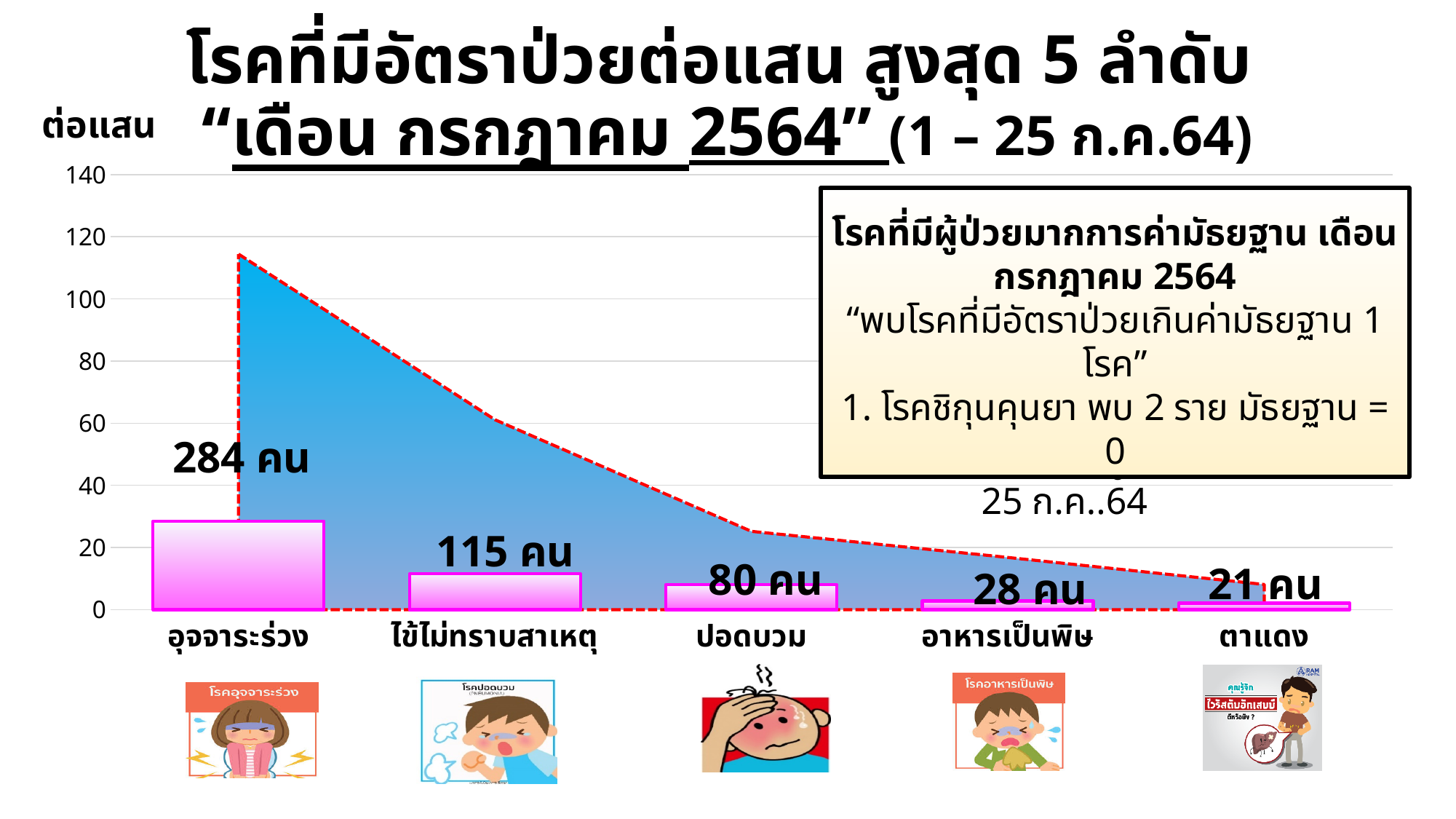
How many cases are labelled for ตาแดง? 21 คน What is the unit label shown at the top of the vertical axis? ต่อแสน What is the difference in cases between อุจจาระร่วง and ไข้ไม่ทราบสาเหตุ? 169 คน Which has more cases, ปอดบวม or อาหารเป็นพิษ? ปอดบวม Do the values rise or fall from left to right along the x axis? fall Which disease has the lowest number of cases? ตาแดง How many cases are labelled for อุจจาระร่วง? 284 คน Is the rate per 100,000 (ต่อแสน) for ปอดบวม greater or less than 40? less How many diseases are shown on the x axis? 5 How many cases are labelled for ปอดบวม? 80 คน Which disease has the highest number of cases? อุจจาระร่วง